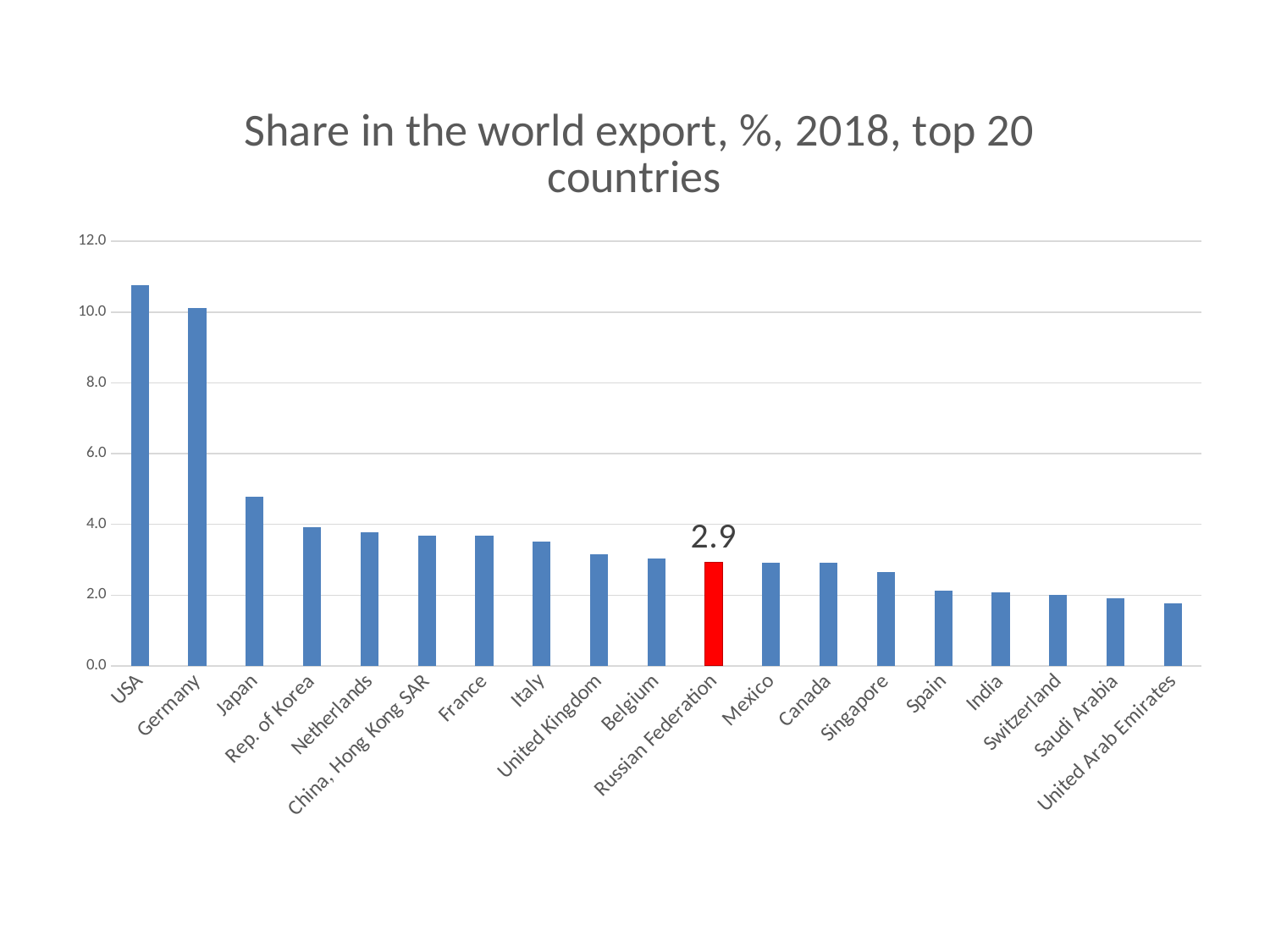
Do the values rise or fall from left to right along the x axis? Fall Which country's bar is coloured red? Russian Federation Which country has the lowest share in the world export? United Arab Emirates What kind of chart is shown on the slide? Bar chart How many countries are shown on the chart? 19 Is the value for Japan greater or less than 6.0? less Is the value for United Arab Emirates greater or less than 2.0? less Which country has the highest share in the world export? USA What is the value for Russian Federation? 2.9 Is the value for USA greater or less than 10.0? greater Which has a larger share, Japan or Rep. of Korea? Japan What is the title of the chart? Share in the world export, %, 2018, top 20 countries